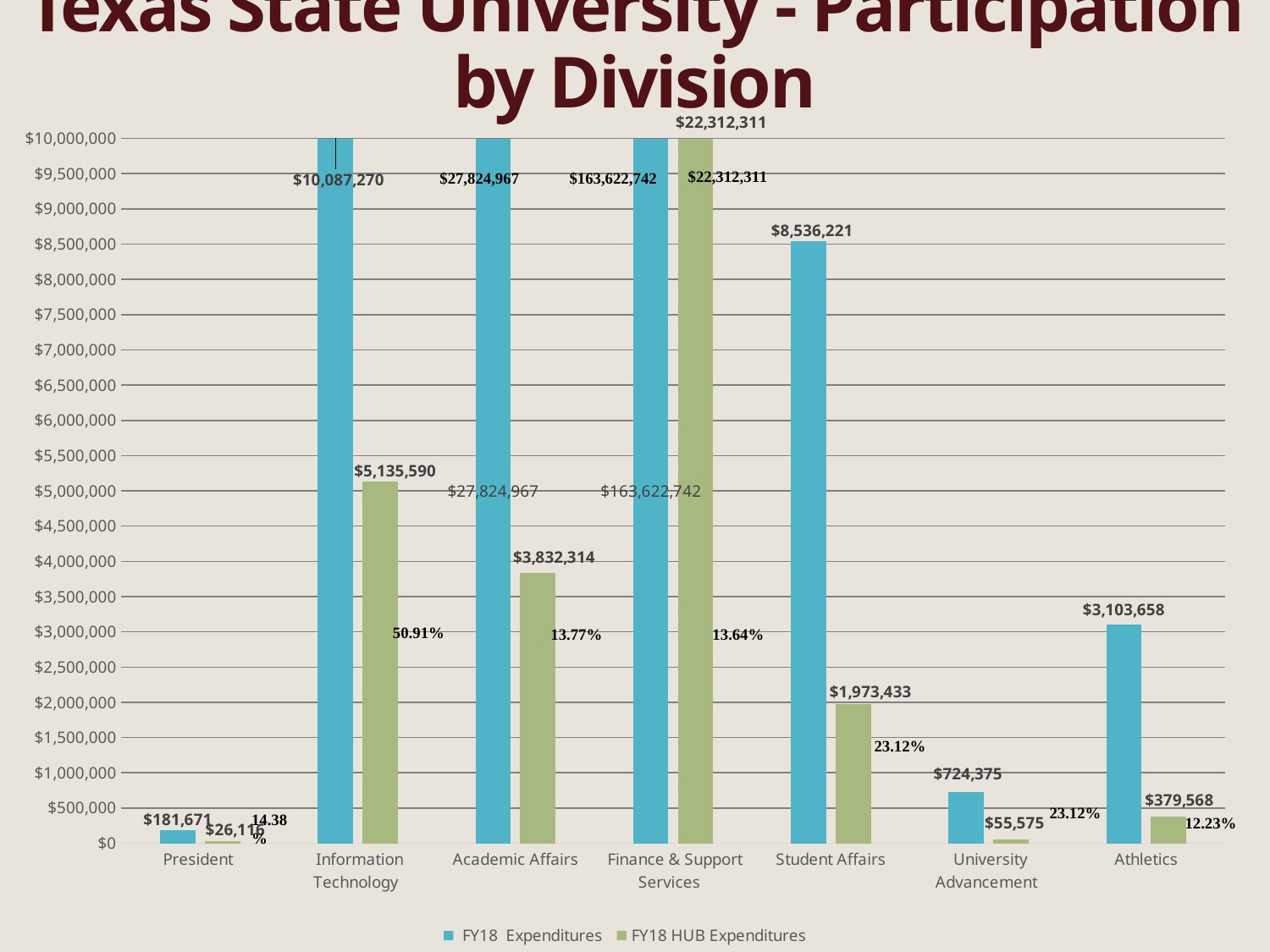
Which division has the lowest FY18 Expenditures? President What is the FY18 Expenditures value for Student Affairs? $8,536,221 Which division has the highest FY18 Expenditures? Finance & Support Services How many divisions are shown on the x axis? 7 What is the FY18 HUB Expenditures value for Information Technology? $5,135,590 What is the difference between FY18 Expenditures and FY18 HUB Expenditures for Student Affairs? $6,562,788 What kind of chart is shown on the slide? Bar chart What is the FY18 Expenditures value for Finance & Support Services? $163,622,742 What HUB participation percentage is shown for Information Technology? 50.91% How many series does the legend list? 2 What is the FY18 HUB Expenditures value for Athletics? $379,568 Which division has larger FY18 Expenditures, Athletics or University Advancement? Athletics